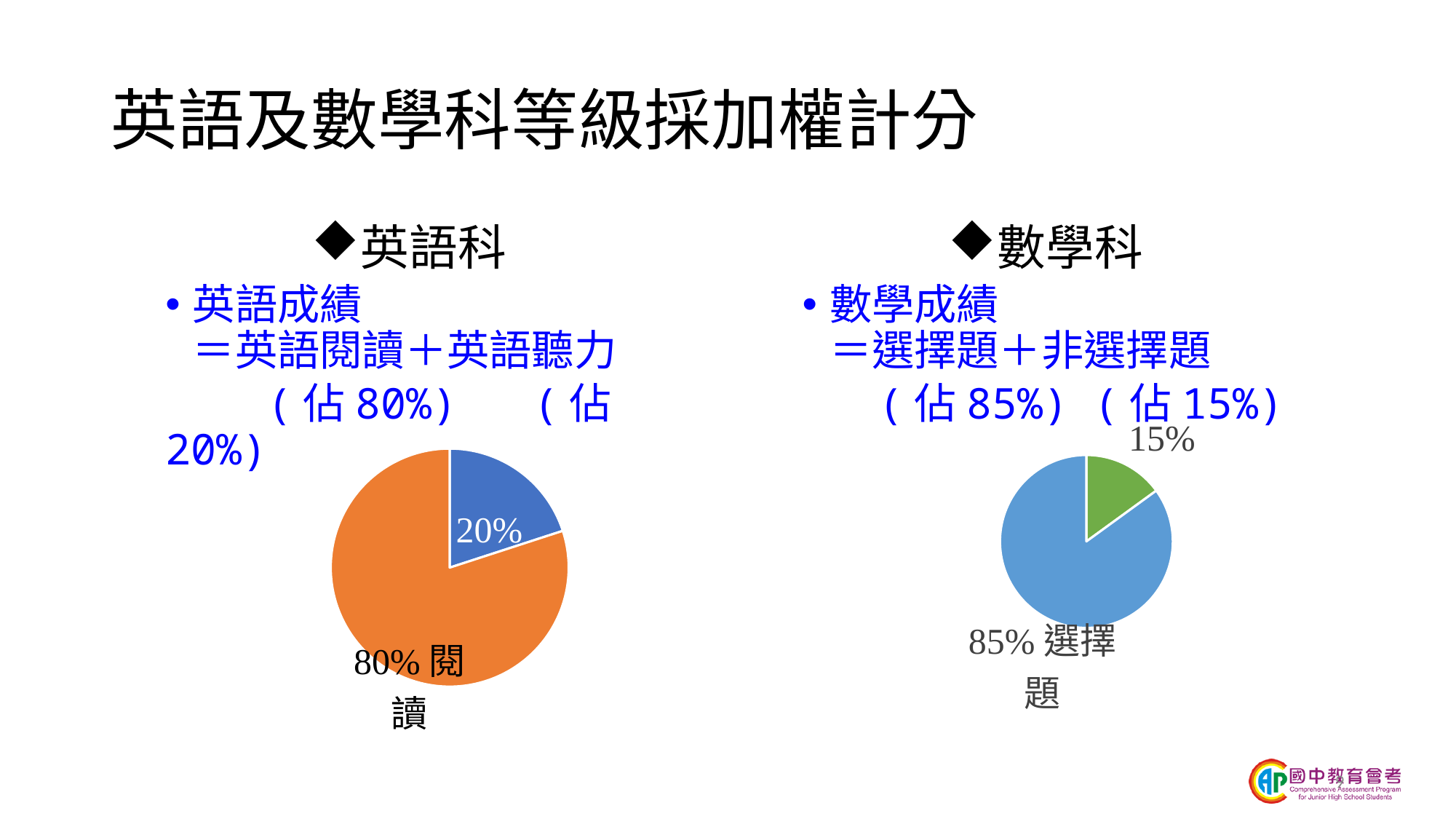
In the right pie chart (數學科), what is the difference between the 85% slice and the 15% slice? 70% In the right pie chart (數學科), which slice is the largest? 選擇題 In the left pie chart (英語科), what share does the 閱讀 slice have? 80% In the left pie chart (英語科), what is the difference between the 80% slice and the 20% slice? 60% What kind of chart is shown under 英語科 on the left of the slide? pie chart In the right pie chart (數學科), what share does the 選擇題 slice have? 85% In the right pie chart (數學科), what share does the green slice have? 15% Which is larger: the 閱讀 slice in the left pie chart or the 選擇題 slice in the right pie chart? 選擇題 What kind of chart is shown under 數學科 on the right of the slide? pie chart How many slices does the left pie chart (英語科) have? 2 In the left pie chart (英語科), which slice is the largest? 閱讀